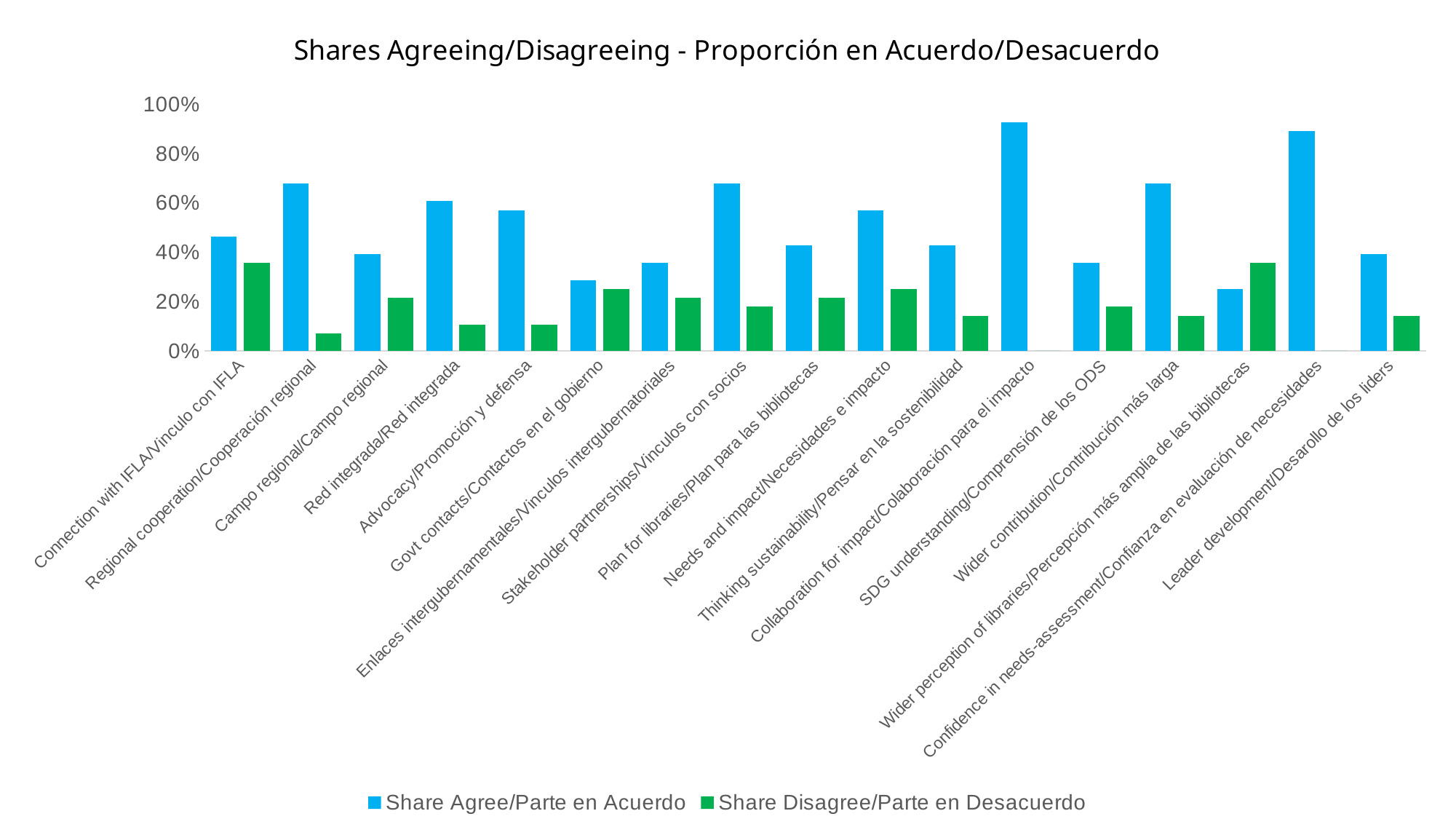
What colour are the Share Disagree/Parte en Desacuerdo bars? green Which category has the highest Share Agree/Parte en Acuerdo value? Collaboration for impact/Colaboración para el impacto Which has the larger Share Agree value: Regional cooperation/Cooperación regional or Campo regional/Campo regional? Regional cooperation/Cooperación regional Is the Share Agree value for Stakeholder partnerships/Vinculos con socios greater or less than 60%? greater Is the Share Agree value for Connection with IFLA/Vinculo con IFLA greater or less than 40%? greater How many categories are shown on the x axis? 17 How many series does the legend list? 2 Is the Share Agree value for Wider perception of libraries/Percepción más amplia de las bibliotecas greater or less than 40%? less What kind of chart is shown on the slide? bar chart Which has the larger Share Disagree value: Connection with IFLA/Vinculo con IFLA or Regional cooperation/Cooperación regional? Connection with IFLA/Vinculo con IFLA